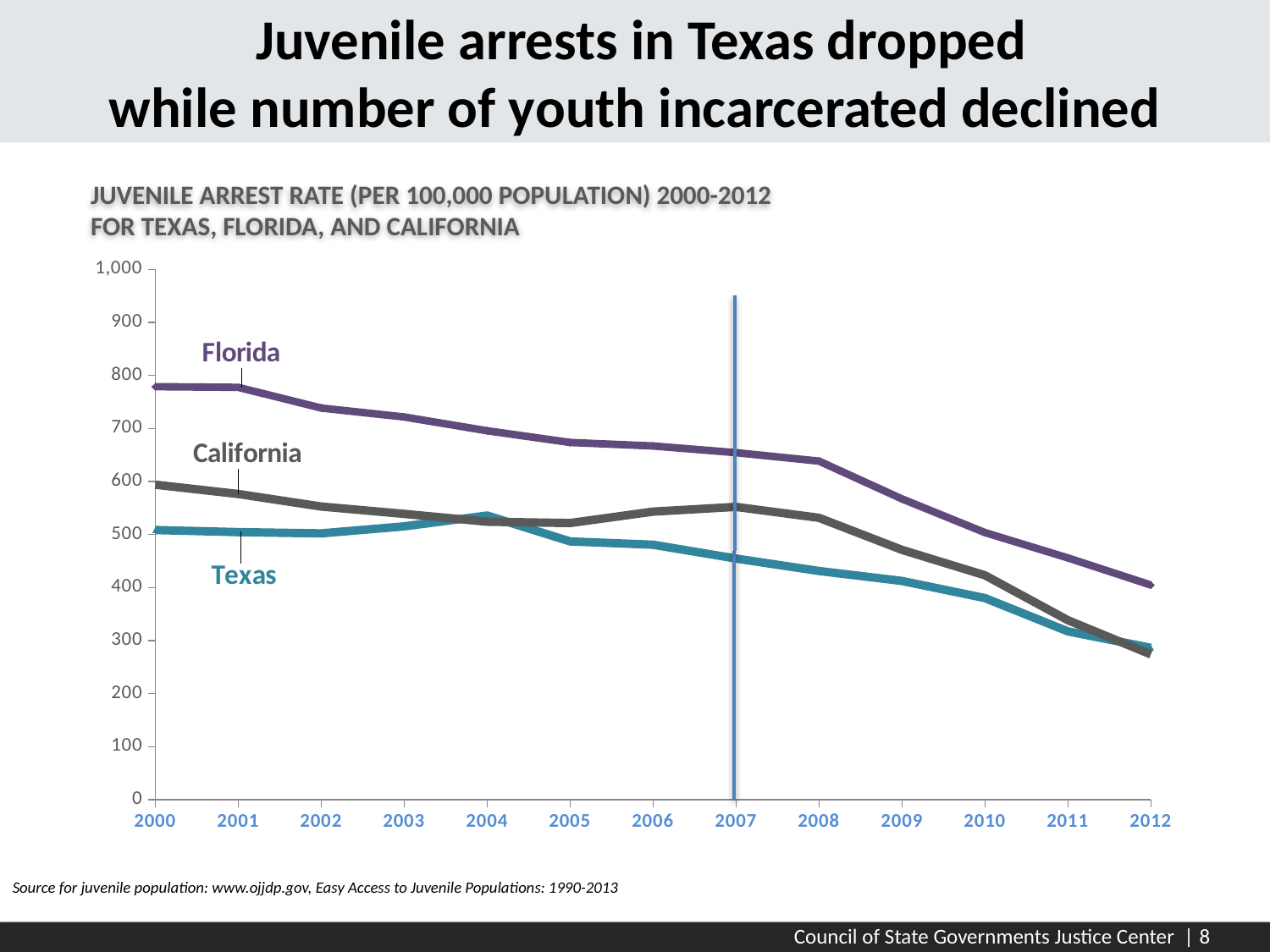
Which state had the highest juvenile arrest rate in 2012? Florida How many years are shown along the x axis of the chart? 13 Is the juvenile arrest rate for Texas in 2010 greater or less than 400? less How many states (series) are plotted on the chart? 3 Is the juvenile arrest rate for Florida in 2008 greater or less than 600? greater At which year is the vertical blue line drawn on the chart? 2007 Which state had the highest juvenile arrest rate in 2000? Florida In 2008, which state had a higher juvenile arrest rate, California or Texas? California What kind of chart is shown on the slide? line chart Which state had the lowest juvenile arrest rate in 2000? Texas Does the juvenile arrest rate for Florida rise or fall from 2000 to 2012? fall Is the juvenile arrest rate for Florida in 2000 greater or less than 700? greater